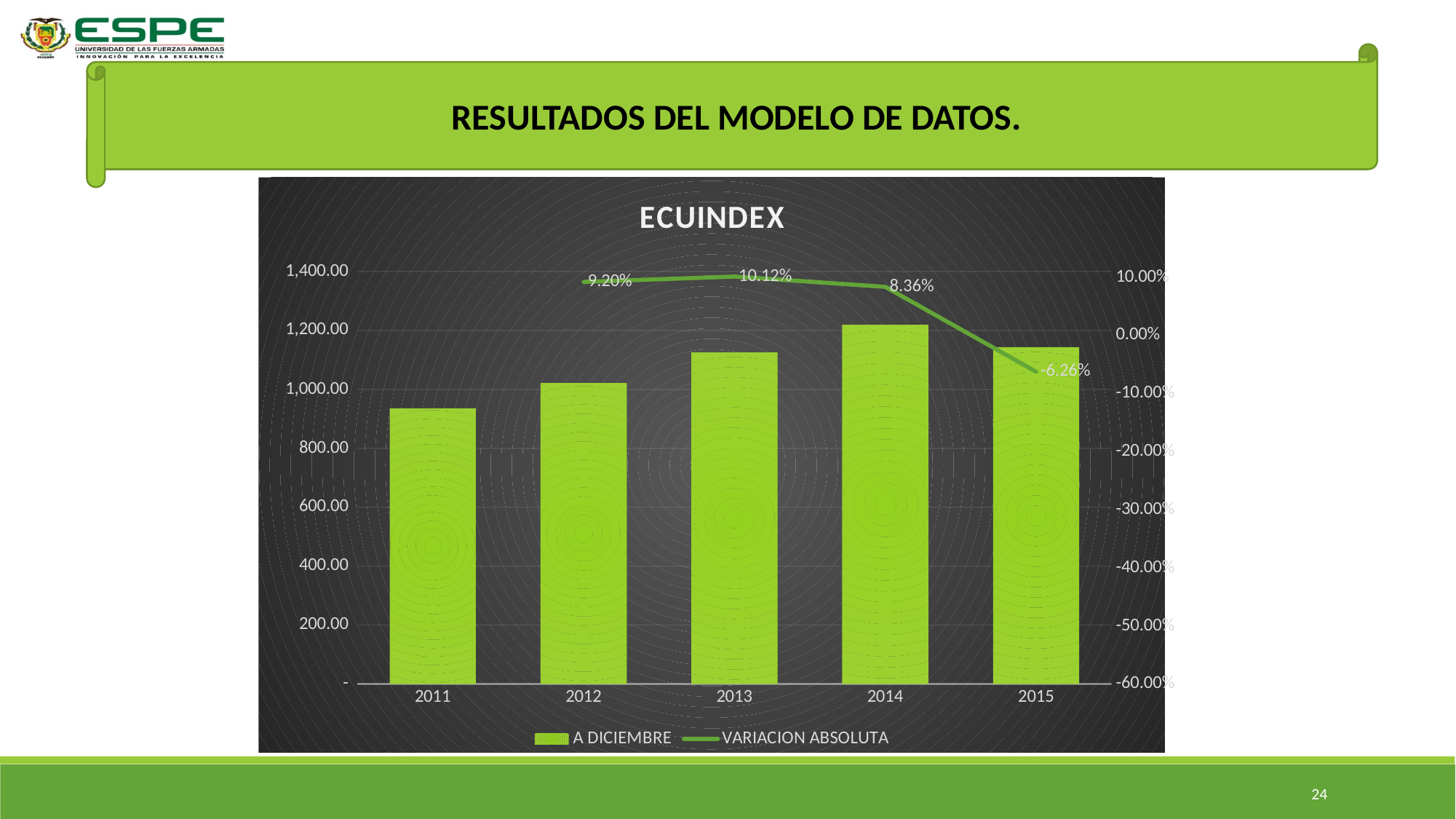
Is the A DICIEMBRE value for 2014 greater or less than 1,200.00 in the ECUINDEX chart? greater Which year has the tallest A DICIEMBRE bar in the ECUINDEX chart? 2014 What is the VARIACION ABSOLUTA value for 2013 in the ECUINDEX chart? 10.12% Which year has the highest VARIACION ABSOLUTA value in the ECUINDEX chart? 2013 What is the difference between the VARIACION ABSOLUTA values for 2013 and 2014 in the ECUINDEX chart? 1.76% How many series does the legend of the ECUINDEX chart list? 2 How many years are shown on the x axis of the ECUINDEX chart? 5 Which year has the lowest VARIACION ABSOLUTA value in the ECUINDEX chart? 2015 What is the VARIACION ABSOLUTA value for 2015 in the ECUINDEX chart? -6.26% What is the VARIACION ABSOLUTA value for 2012 in the ECUINDEX chart? 9.20% Is the A DICIEMBRE value for 2011 greater or less than 1,000.00 in the ECUINDEX chart? less Does the A DICIEMBRE bar value rise or fall from 2011 to 2014 in the ECUINDEX chart? rise